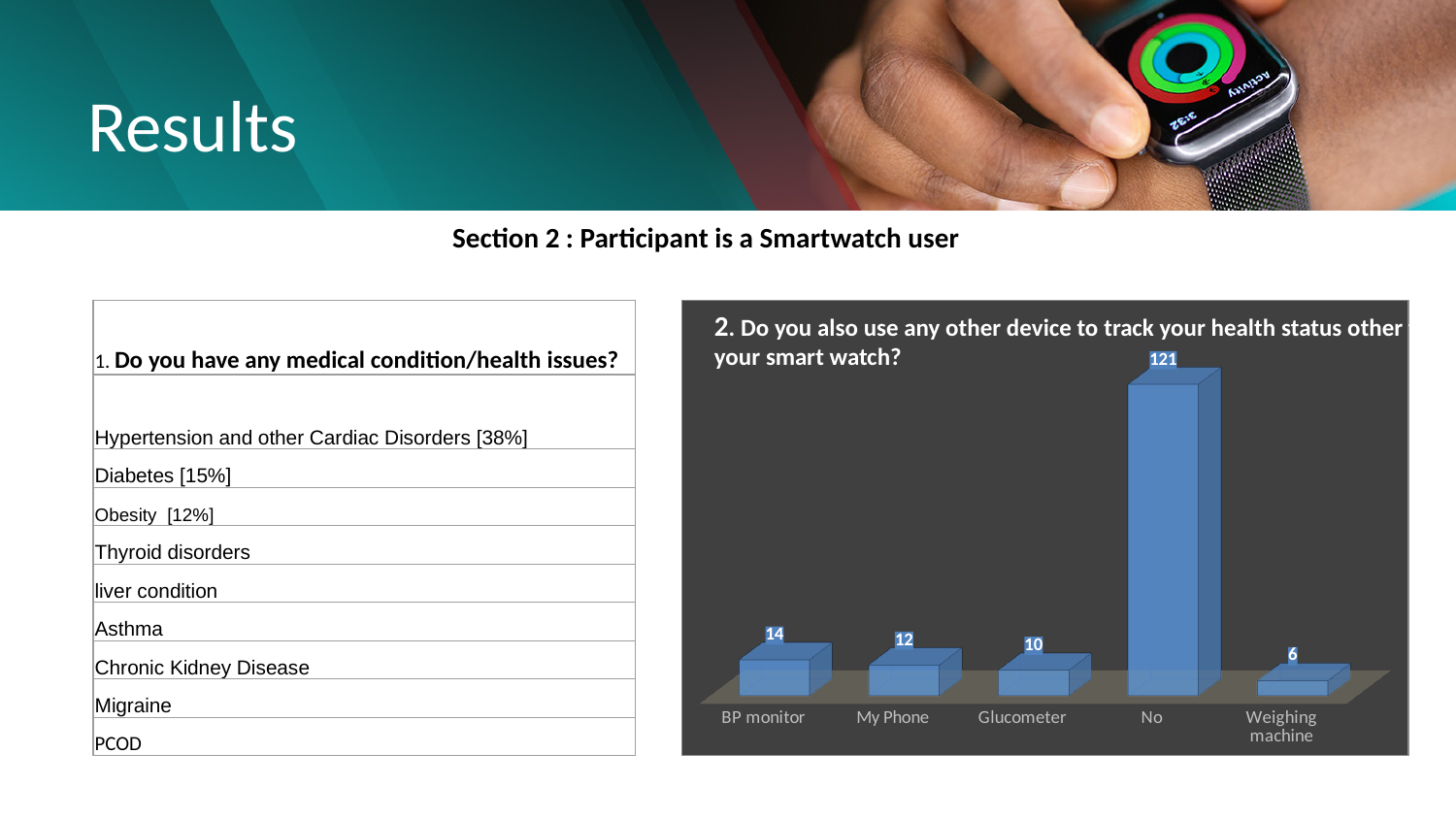
What is the difference between the values for No and BP monitor? 107 What is the value for Glucometer in the chart? 10 How many categories are shown in the chart? 5 What is the value for My Phone in the chart? 12 What is the value for Weighing machine in the chart? 6 What kind of chart is shown on the slide? Bar chart What is the title of the chart? 2. Do you also use any other device to track your health status other your smart watch? Which is larger, the value for BP monitor or the value for Glucometer? BP monitor Which category has the highest value in the chart? No Which category has the lowest value in the chart? Weighing machine What is the value for BP monitor in the chart? 14 What is the value for No in the chart? 121